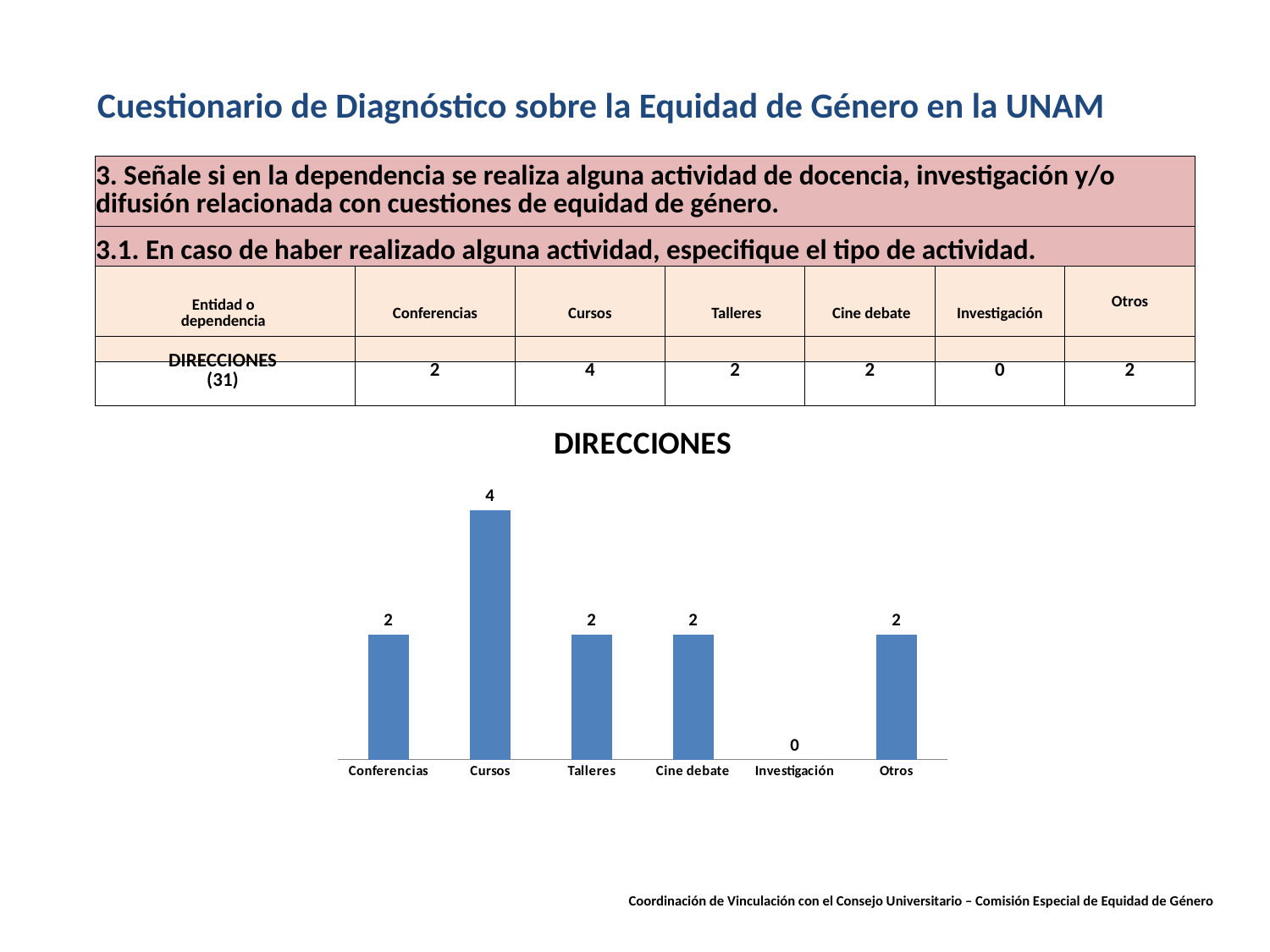
What kind of chart is the DIRECCIONES chart? Bar chart What is the value for Cursos in the DIRECCIONES chart? 4 Which is larger in the DIRECCIONES chart, the value for Cursos or the value for Otros? Cursos What is the value for Investigación in the DIRECCIONES chart? 0 How many categories are shown on the x axis of the DIRECCIONES chart? 6 What is the title of the chart on the slide? DIRECCIONES What is the difference between the values for Cursos and Talleres in the DIRECCIONES chart? 2 Which category has the highest value in the DIRECCIONES chart? Cursos What is the value for Conferencias in the DIRECCIONES chart? 2 What is the difference between the values for Cursos and Investigación in the DIRECCIONES chart? 4 Which category has the lowest value in the DIRECCIONES chart? Investigación What is the value for Cine debate in the DIRECCIONES chart? 2